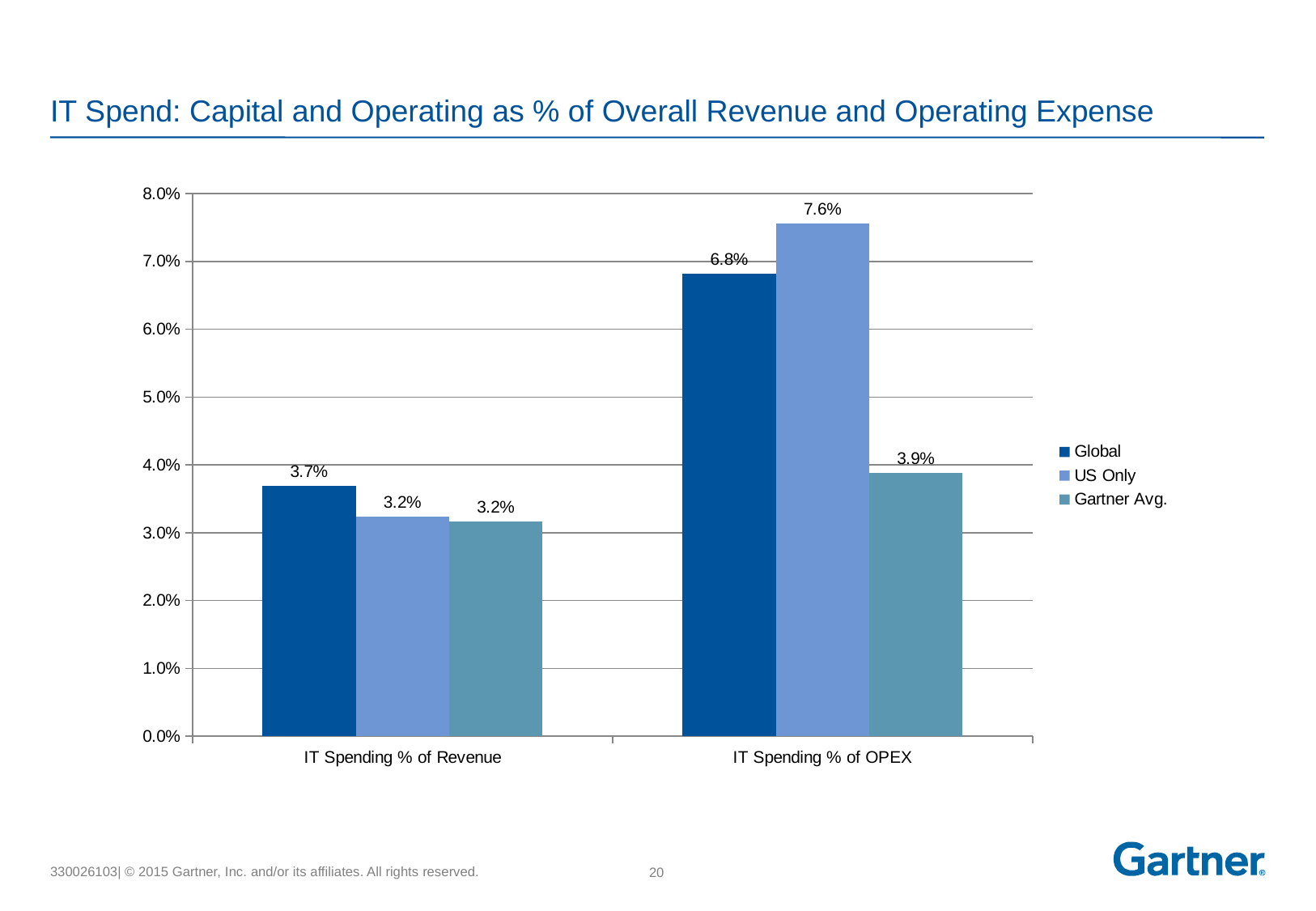
What is the Global value for IT Spending % of Revenue? 3.7% Which is larger for IT Spending % of Revenue: the Global value or the US Only value? Global Which series has the lowest value for IT Spending % of OPEX? Gartner Avg. What is the Global value for IT Spending % of OPEX? 6.8% What kind of chart is shown on the slide? Bar chart How many series does the legend list? 3 What is the difference between the US Only and Global values for IT Spending % of OPEX? 0.8% Is the Global value for IT Spending % of OPEX greater or less than 6.0%? greater What is the Gartner Avg. value for IT Spending % of OPEX? 3.9% What is the US Only value for IT Spending % of OPEX? 7.6% What is the title of the slide? IT Spend: Capital and Operating as % of Overall Revenue and Operating Expense Which series has the highest value for IT Spending % of OPEX? US Only